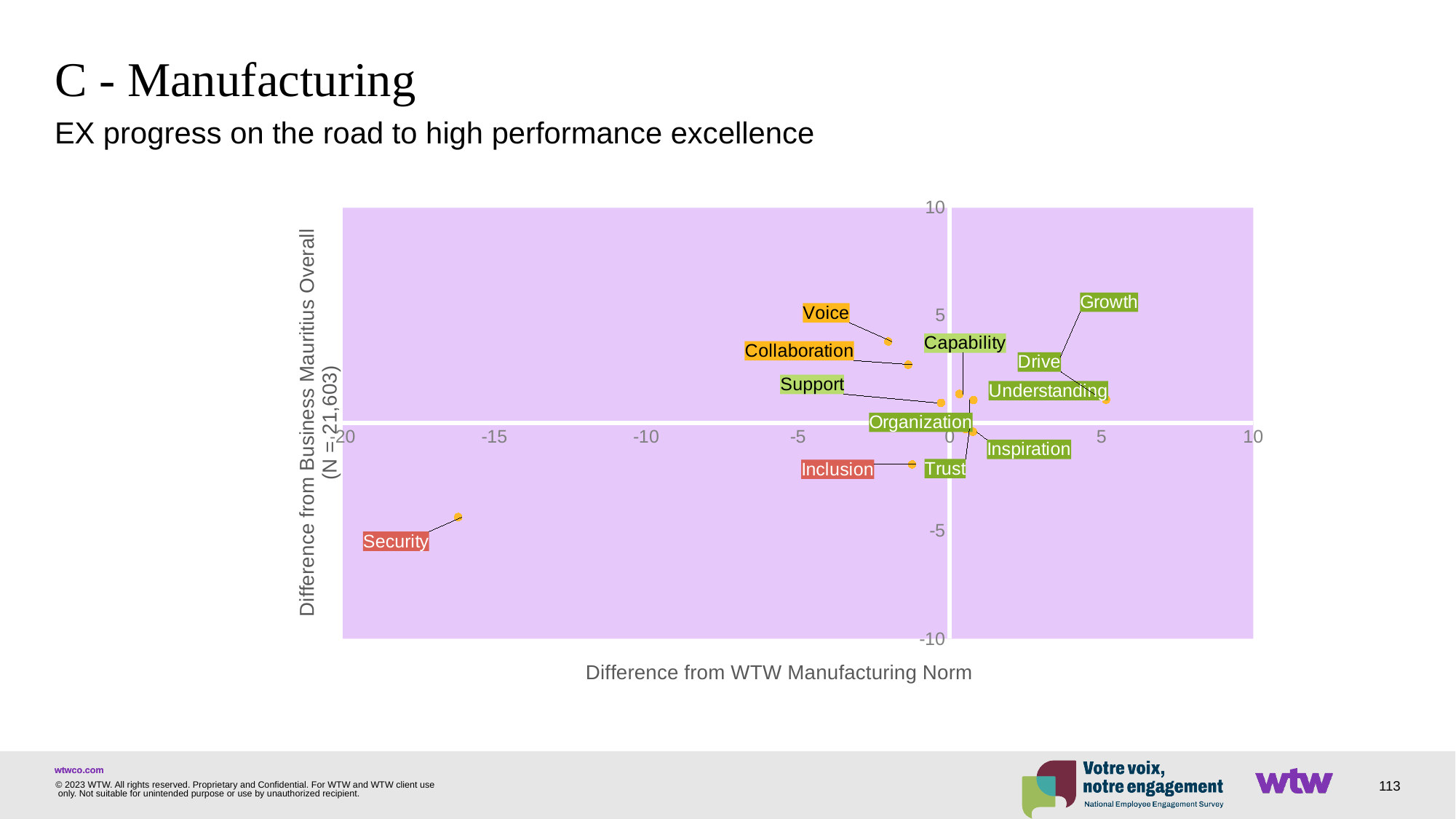
Is the vertical-axis value for Security greater or less than -5? greater What is the title of the horizontal axis of the chart? Difference from WTW Manufacturing Norm What is the title of the vertical axis of the chart? Difference from Business Mauritius Overall (N = 21,603) Which labelled point has the highest value on the vertical axis (Difference from Business Mauritius Overall)? Voice What kind of chart is shown on the slide? scatter chart Is the vertical-axis value for Voice greater or less than 5? less Which has the larger horizontal-axis value, Security or Inclusion? Inclusion Which labelled point has the lowest value on the horizontal axis (Difference from WTW Manufacturing Norm)? Security Which labelled point has the lowest value on the vertical axis (Difference from Business Mauritius Overall)? Security Is the vertical-axis value for Inclusion greater or less than 0? less How many labelled data points are plotted on the chart? 12